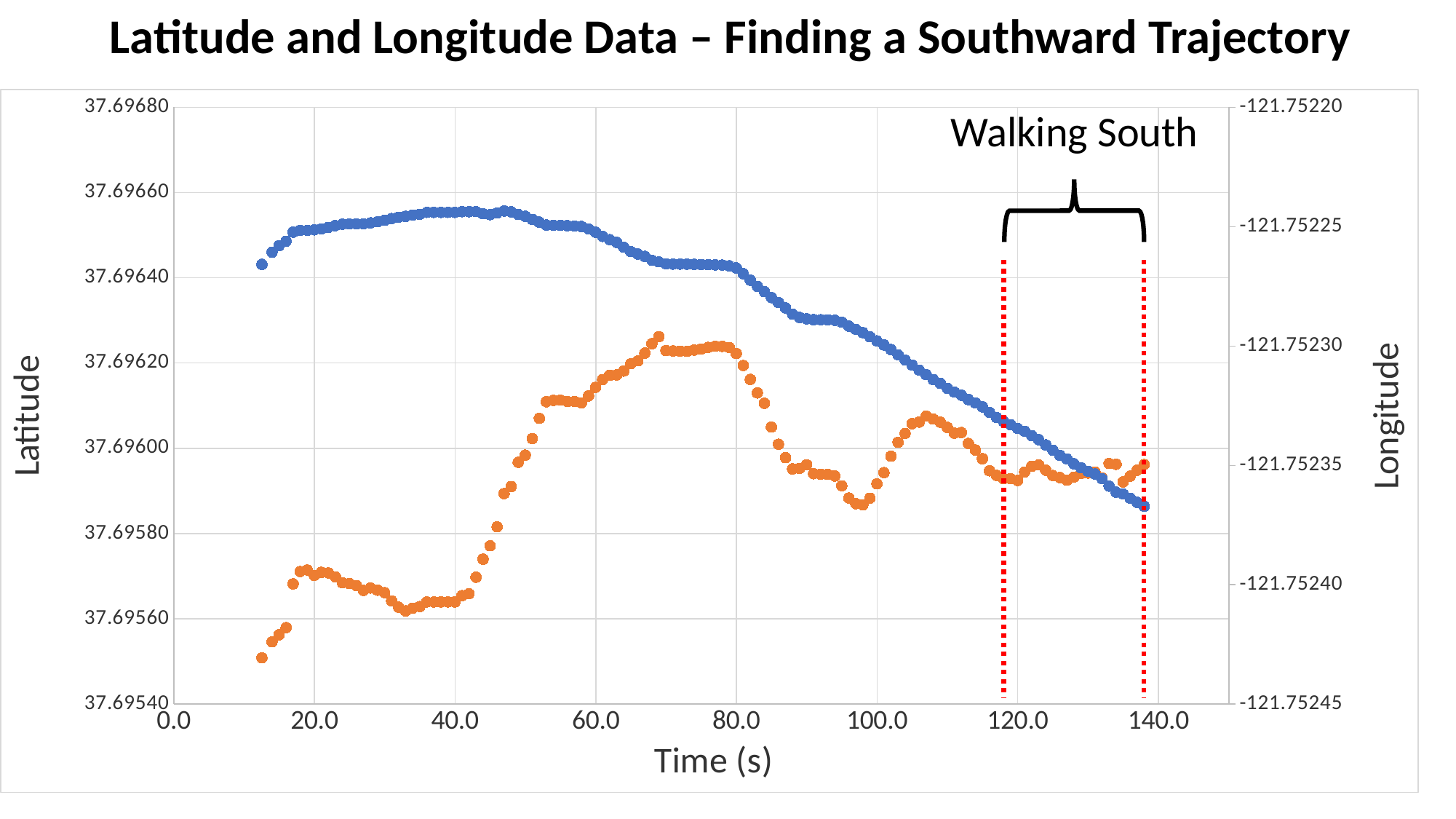
Is the latitude value at the end of the series (around 138 s) greater or less than 37.69600? less What text annotation is written above the bracketed region on the right side of the chart? Walking South How many data series are plotted on the chart? 2 Which is larger, the longitude value at 30.0 s or the longitude value at 70.0 s? The value at 70.0 s Is the latitude value at 120.0 s greater or less than 37.69620? less What is the title of the chart? Latitude and Longitude Data – Finding a Southward Trajectory What kind of chart is shown on the slide? Scatter chart Does the latitude (blue) series rise or fall between 120.0 s and 140.0 s? Fall Is the latitude value at 60.0 s greater or less than 37.69640? greater Does the longitude (orange) series rise or fall between 40.0 s and 60.0 s? Rise Which is larger, the latitude value at 20.0 s or the latitude value at 120.0 s? The value at 20.0 s